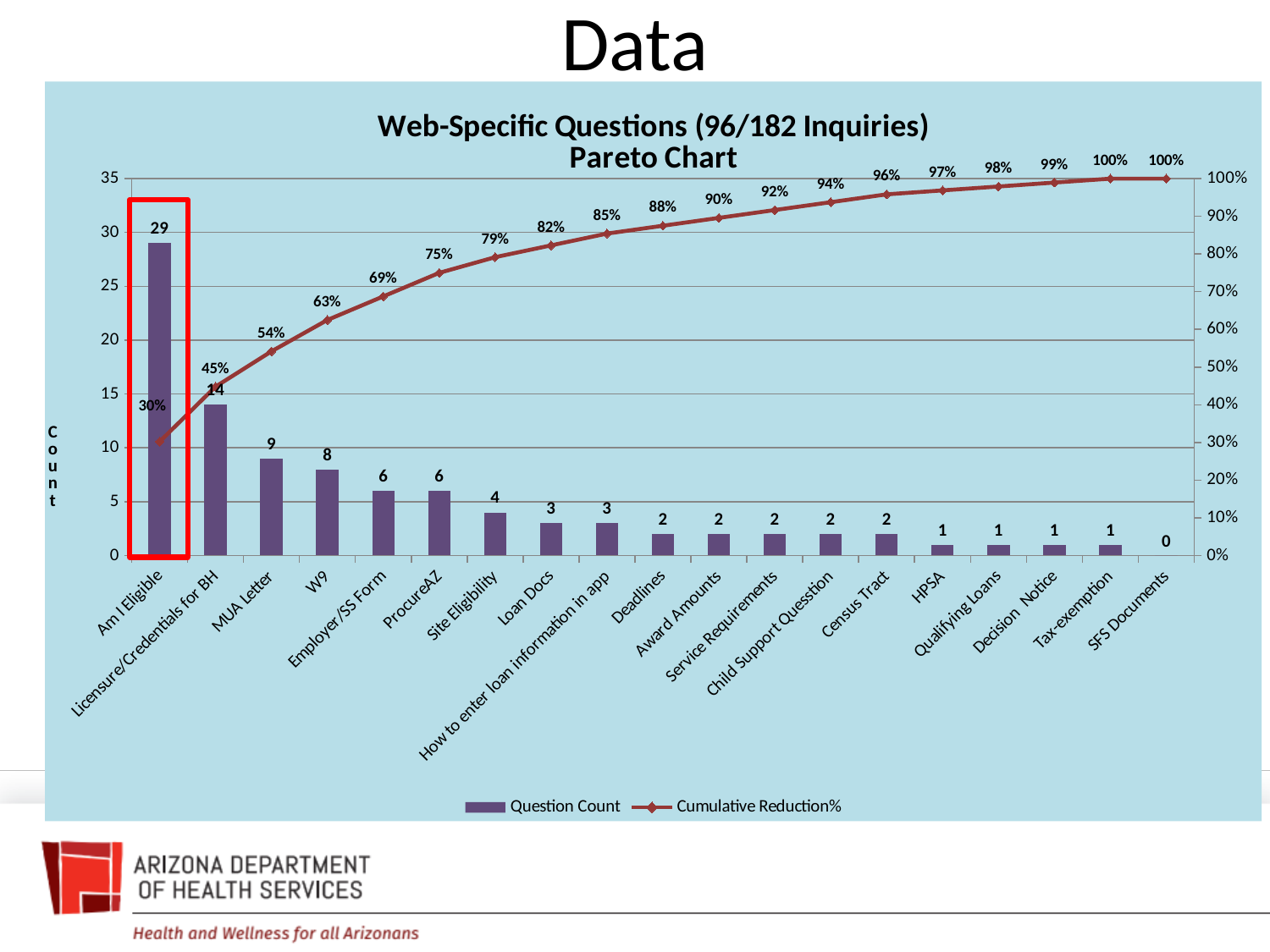
What is the Cumulative Reduction% value at W9? 63% Which category has the lowest Question Count? SFS Documents What is the Question Count for Licensure/Credentials for BH? 14 What is the Question Count for Am I Eligible? 29 What is the title of the chart? Web-Specific Questions (96/182 Inquiries) Pareto Chart How many series does the legend list? 2 What is the Question Count for Site Eligibility? 4 Which category has the highest Question Count? Am I Eligible How many categories are shown on the x axis? 19 What is the difference in Question Count between Am I Eligible and Licensure/Credentials for BH? 15 Does the Cumulative Reduction% line rise or fall from left to right? Rise Which has a higher Question Count, MUA Letter or W9? MUA Letter